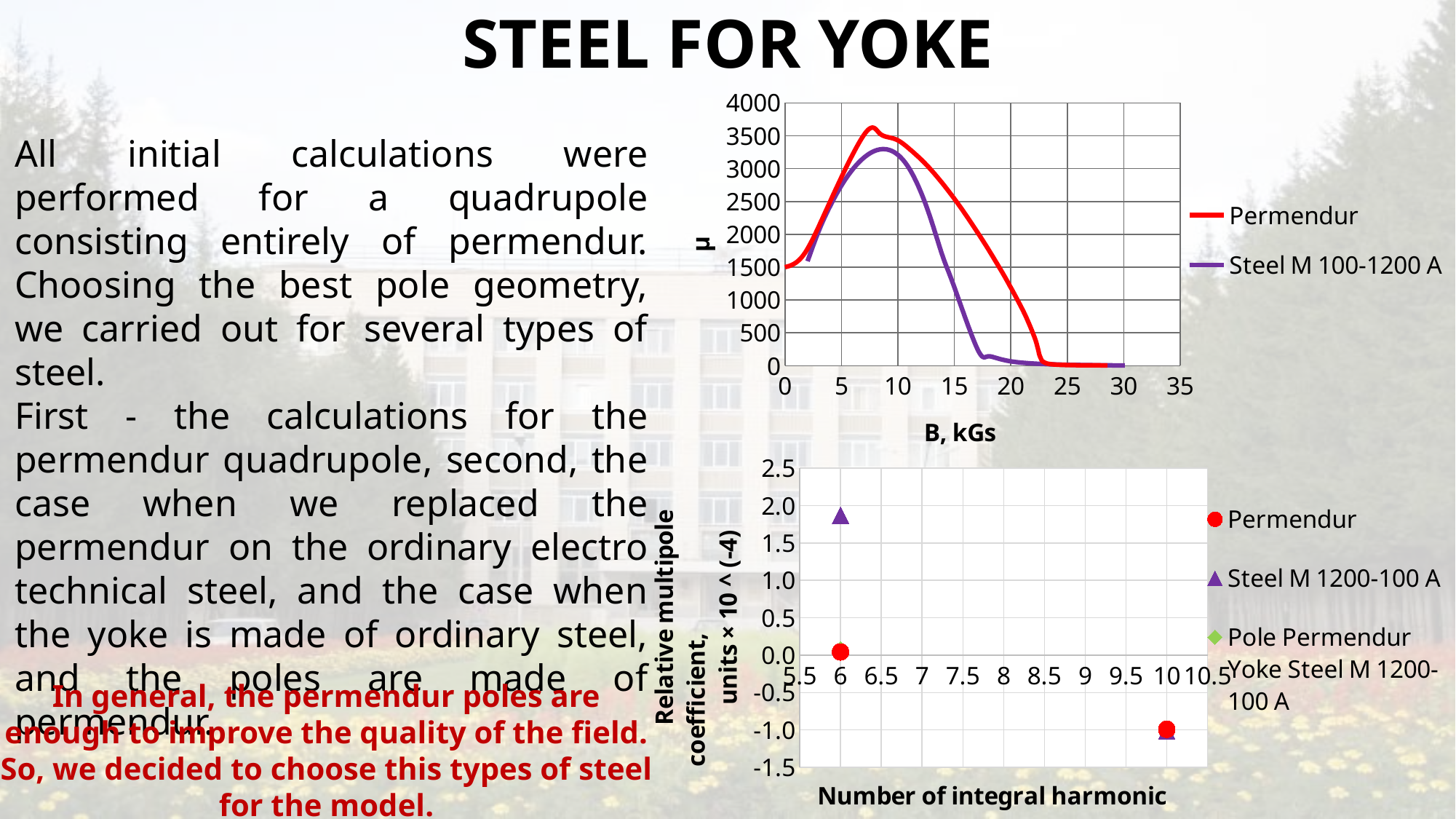
In the top chart (μ versus B, kGs), is the μ value for Steel M 100-1200 A at B = 20 kGs greater or less than 500? less What kind of chart is the top chart (μ versus B, kGs)? line chart How many series does the legend of the bottom chart (Relative multipole coefficient versus Number of integral harmonic) list? 3 How many series does the legend of the top chart (μ versus B, kGs) list? 2 In the bottom chart (Relative multipole coefficient versus Number of integral harmonic), what is the label of the x axis? Number of integral harmonic In the top chart (μ versus B, kGs), do the Permendur values rise or fall as B increases from 10 to 25 kGs? fall In the bottom chart (Relative multipole coefficient versus Number of integral harmonic), is the value for Permendur at harmonic 10 greater or less than -0.5? less In the bottom chart (Relative multipole coefficient versus Number of integral harmonic), is the value for Steel M 1200-100 A at harmonic 6 greater or less than 1.5? greater In the top chart (μ versus B, kGs), which series has the higher μ at B = 15 kGs, Permendur or Steel M 100-1200 A? Permendur In the bottom chart (Relative multipole coefficient versus Number of integral harmonic), which series has the larger value at harmonic 6, Permendur or Steel M 1200-100 A? Steel M 1200-100 A In the top chart (μ versus B, kGs), what is the label of the x axis? B, kGs